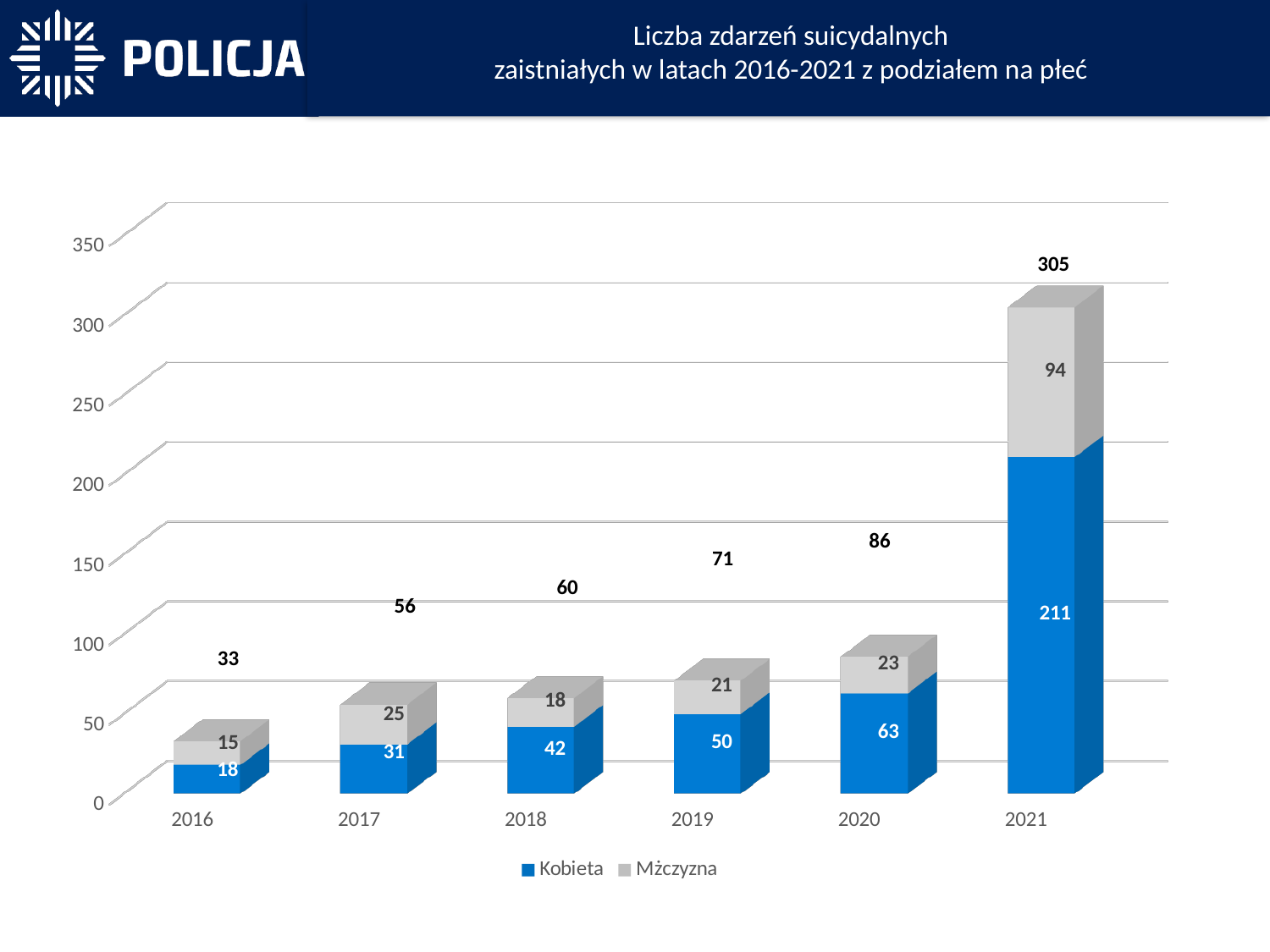
Is the total for 2021 greater or less than 300? greater What is the value for Kobieta in 2021? 211 Which year has the highest total? 2021 What is the total of the stacked bar for 2019? 71 How many years are shown on the x axis? 6 Which year has the lowest value for Kobieta? 2016 How many series does the legend list? 2 What is the value for Mżczyzna in 2017? 25 Which is larger, the Mżczyzna value for 2019 or for 2020? 2020 What is the difference between the Kobieta values for 2020 and 2018? 21 What kind of chart is shown? stacked bar chart Do the totals rise or fall from 2016 to 2021? rise